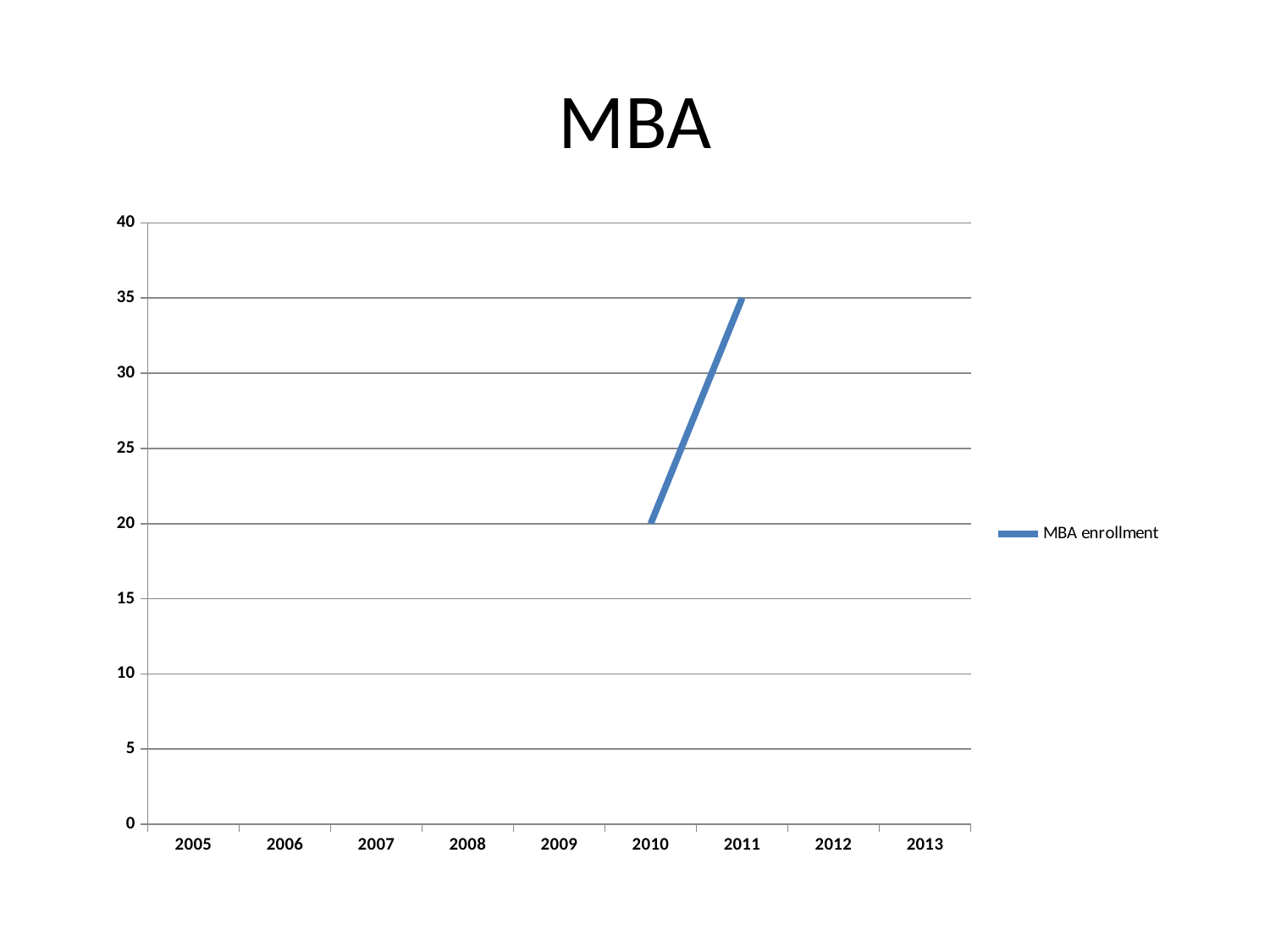
Is the MBA enrollment value for 2011 greater or less than 30? greater What is the MBA enrollment value for 2010? 20 What is the name of the series shown in the legend? MBA enrollment What is the difference in MBA enrollment between 2011 and 2010? 15 How many series does the legend list? 1 Is the MBA enrollment value for 2010 greater or less than 25? less Does MBA enrollment rise or fall from 2010 to 2011? rise What kind of chart is shown on the slide? line chart Which year has the higher MBA enrollment, 2010 or 2011? 2011 What is the title of the chart? MBA What is the MBA enrollment value for 2011? 35 How many years are labelled on the x axis? 9